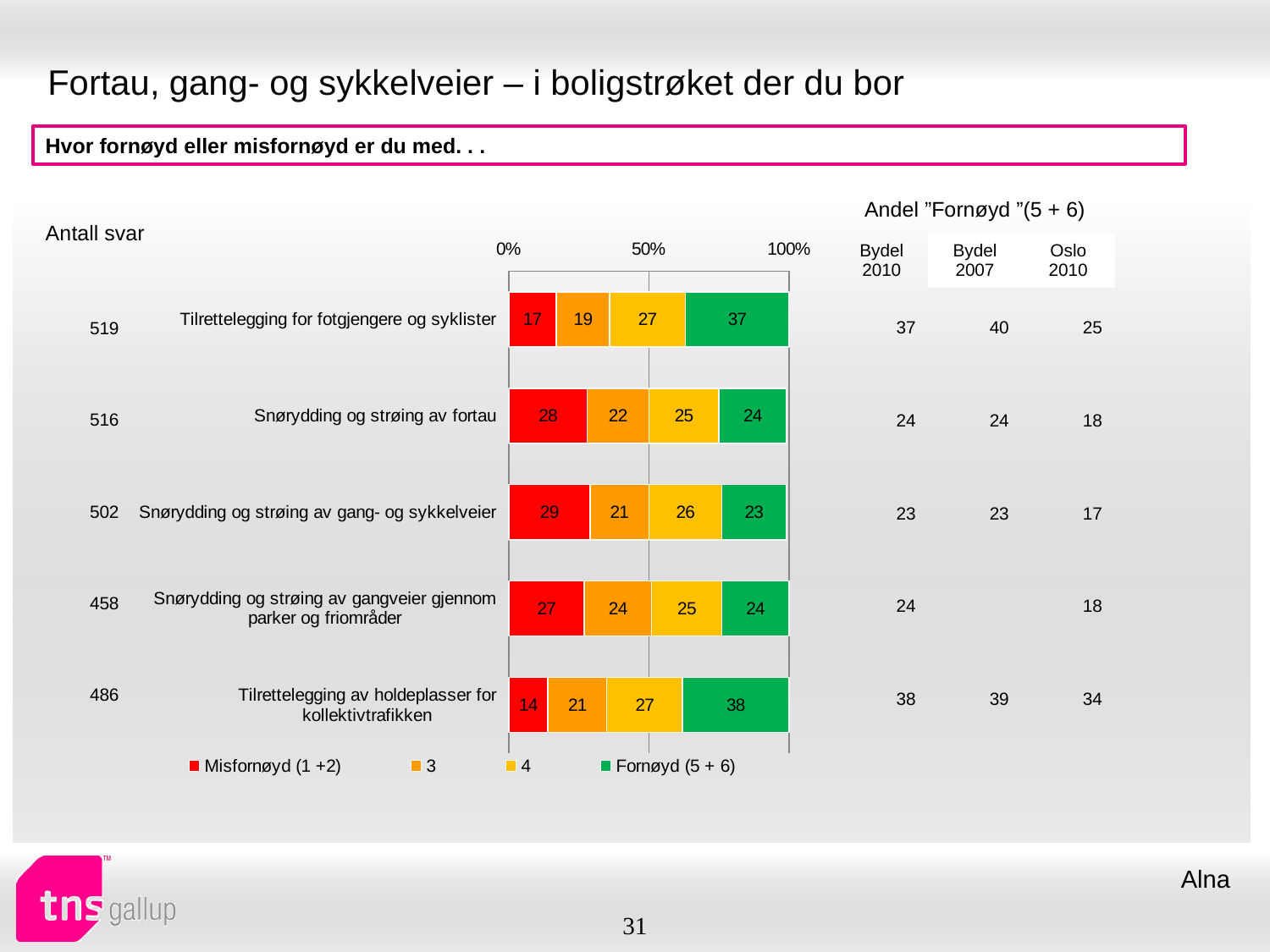
What is the value of series 3 for Snørydding og strøing av gangveier gjennom parker og friområder? 24 What is the difference between the Fornøyd (5 + 6) value for Tilrettelegging av holdeplasser for kollektivtrafikken and for Snørydding og strøing av gang- og sykkelveier? 15 Which category has the highest Fornøyd (5 + 6) value? Tilrettelegging av holdeplasser for kollektivtrafikken What is the Misfornøyd (1 +2) value for Snørydding og strøing av fortau? 28 How many series does the legend list? 4 Which is larger: the Misfornøyd (1 +2) value for Snørydding og strøing av fortau or for Tilrettelegging for fotgjengere og syklister? Snørydding og strøing av fortau How many categories are shown in the bar chart? 5 Which category has the lowest Misfornøyd (1 +2) value? Tilrettelegging av holdeplasser for kollektivtrafikken What is the total of the stacked bar for Tilrettelegging for fotgjengere og syklister? 100 What is the Fornøyd (5 + 6) value for Tilrettelegging for fotgjengere og syklister? 37 What is the value of series 4 for Snørydding og strøing av gang- og sykkelveier? 26 What kind of chart is shown on the slide? Stacked bar chart